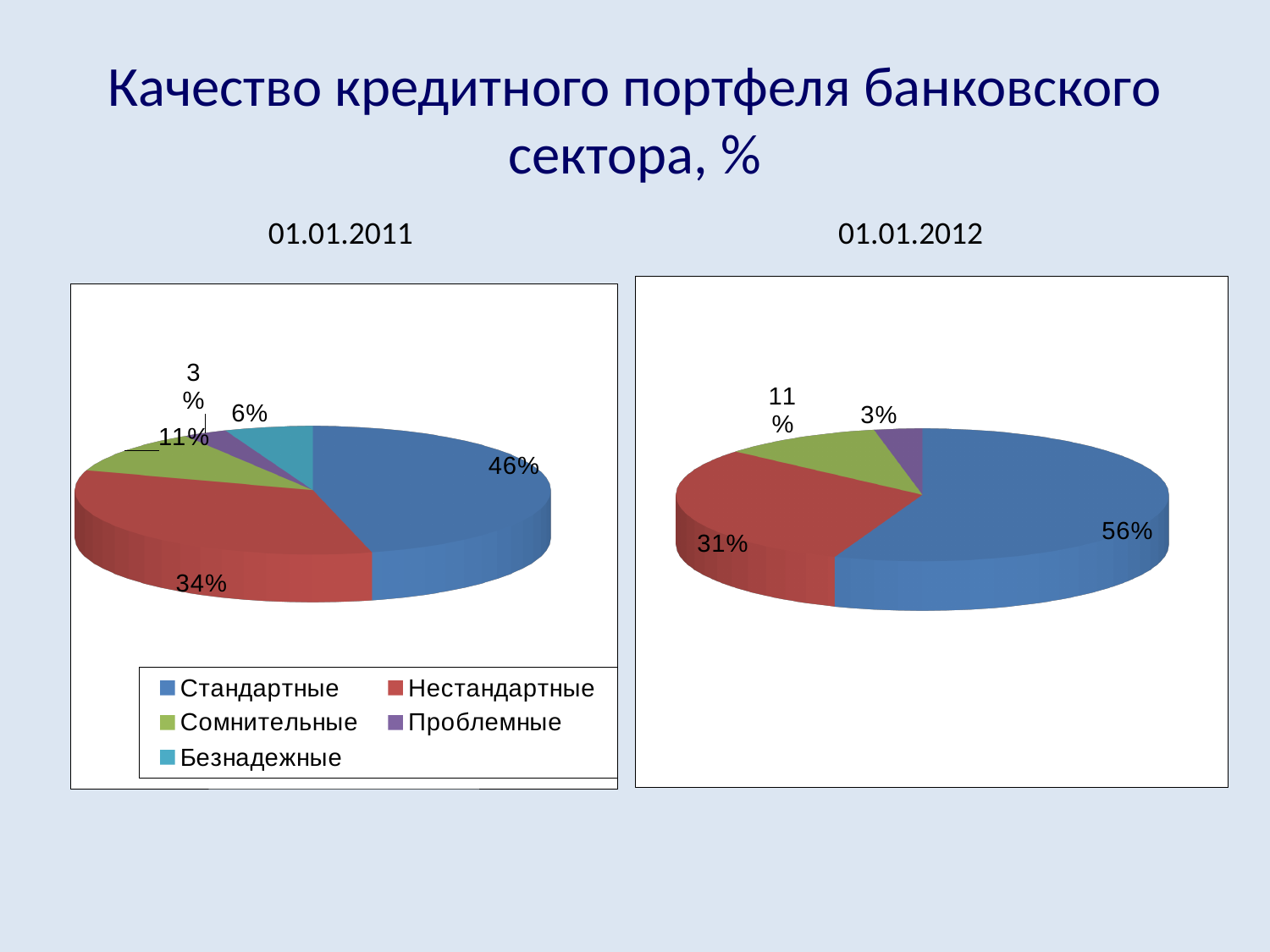
In the 01.01.2011 chart, what share do Нестандартные loans have? 34% How many slices does the 01.01.2012 pie chart have? 4 In the 01.01.2011 chart, which category has the largest share? Стандартные How many categories does the legend of the 01.01.2011 chart list? 5 Which is larger: the blue slice in the 01.01.2011 chart or the blue slice in the 01.01.2012 chart? 01.01.2012 In the 01.01.2011 chart, what share do Стандартные loans have? 46% In the 01.01.2011 chart, what share do Безнадежные loans have? 6% In the 01.01.2012 chart, what is the share of the largest (blue) slice? 56% In the 01.01.2012 chart, what is the share of the red slice? 31% What kind of chart is shown for 01.01.2011? pie chart In the 01.01.2011 chart, which category has the smallest share? Проблемные In the 01.01.2011 chart, what is the difference between the Стандартные and Нестандартные shares? 12%